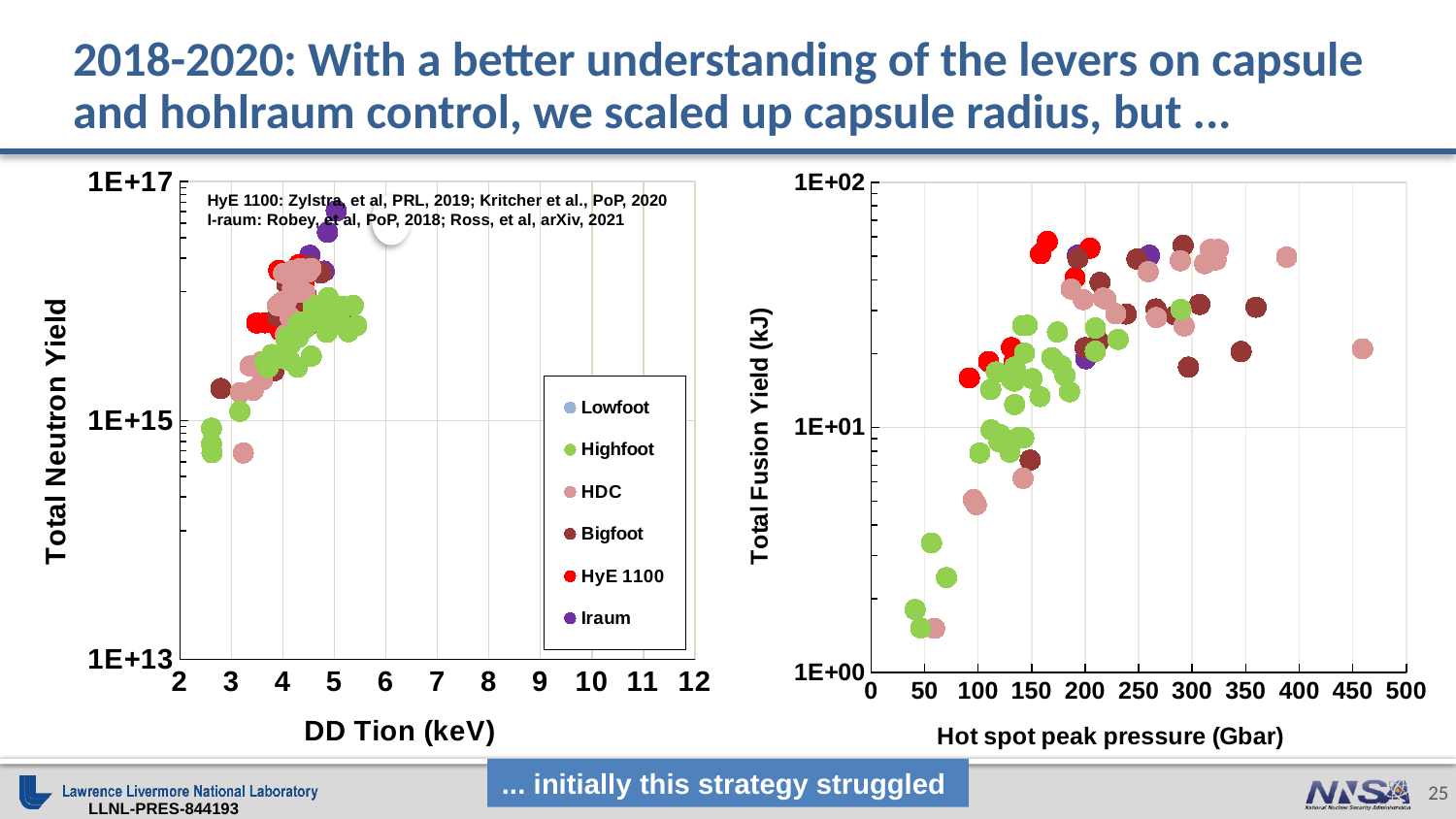
On the left chart, is the Bigfoot value near 3 keV greater or less than 1E+15? greater On the right chart, are the Bigfoot values near 300 Gbar greater or less than 1E+02 kJ? less On the right chart, does Total Fusion Yield generally rise or fall as Hot spot peak pressure increases? rise How many series does the legend on the left chart list? 6 On the right chart, what is the label of the y axis? Total Fusion Yield (kJ) On the right chart, are the Highfoot values near 50 Gbar greater or less than 1E+01 kJ? less On the right chart, which series has the point at the highest Hot spot peak pressure? HDC What kind of chart is the left chart (Total Neutron Yield vs DD Tion)? scatter chart What kind of chart is the right chart (Total Fusion Yield vs Hot spot peak pressure)? scatter chart On the left chart, does Total Neutron Yield generally rise or fall as DD Tion increases? rise On the left chart, what is the label of the x axis? DD Tion (keV)